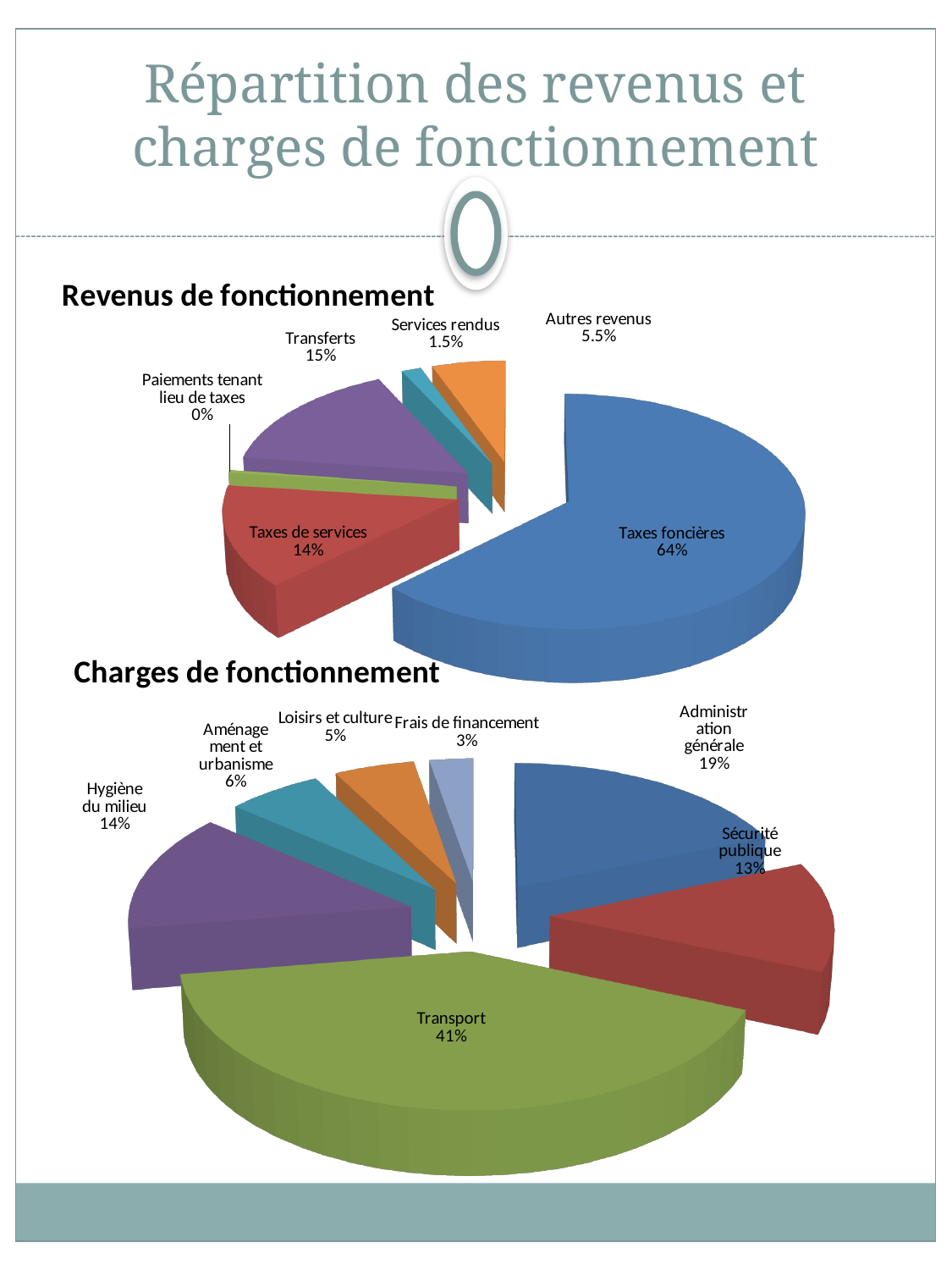
In the 'Charges de fonctionnement' chart, which category has the largest share? Transport What type of chart is used for 'Charges de fonctionnement'? Pie chart In the 'Revenus de fonctionnement' chart, which category has the smallest share? Paiements tenant lieu de taxes In the 'Revenus de fonctionnement' chart, what is the percentage for Transferts? 15% In the 'Revenus de fonctionnement' chart, which is larger, Autres revenus or Services rendus? Autres revenus In the 'Revenus de fonctionnement' chart, what share does Taxes foncières represent? 64% In the 'Revenus de fonctionnement' chart, how many categories are shown? 6 In the 'Revenus de fonctionnement' chart, what is the difference between Transferts and Taxes de services? 1% In the 'Charges de fonctionnement' chart, how many categories are shown? 7 In the 'Charges de fonctionnement' chart, what is the difference between Administration générale and Sécurité publique? 6% In the 'Charges de fonctionnement' chart, which category has the smallest share? Frais de financement In the 'Charges de fonctionnement' chart, what share does Transport represent? 41%